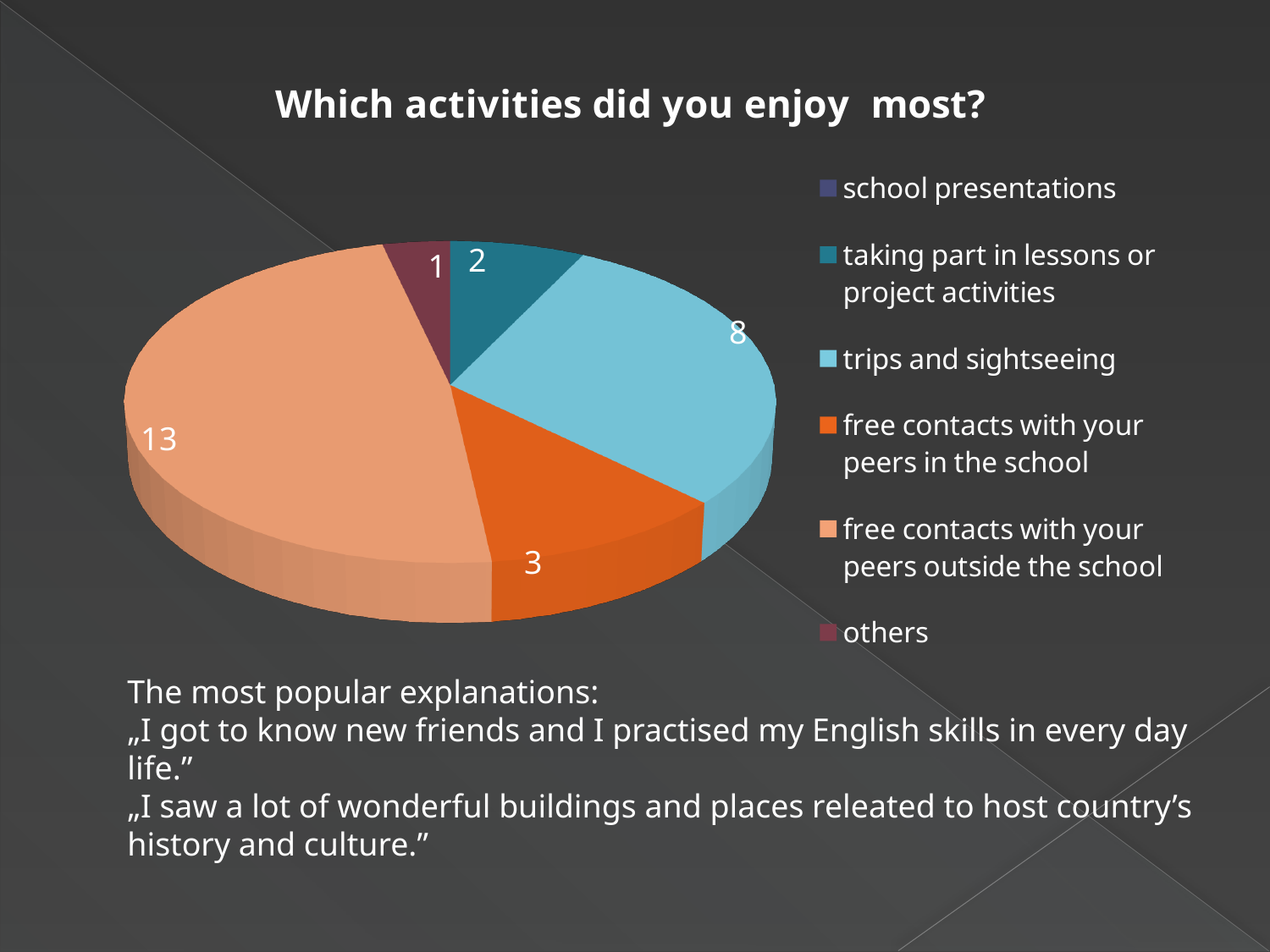
What type of chart is shown on the slide? pie chart How many entries does the legend list? 6 What colour is the slice for "trips and sightseeing"? light blue Which activity has the largest slice of the pie? free contacts with your peers outside the school What is the value for "free contacts with your peers outside the school"? 13 What is the value for "others"? 1 What is the title of the chart? Which activities did you enjoy most? What is the difference between the values for "free contacts with your peers outside the school" and "trips and sightseeing"? 5 What is the value for "taking part in lessons or project activities"? 2 Which is larger: the value for "trips and sightseeing" or the value for "free contacts with your peers in the school"? trips and sightseeing What is the value for "free contacts with your peers in the school"? 3 What is the value for "trips and sightseeing"? 8